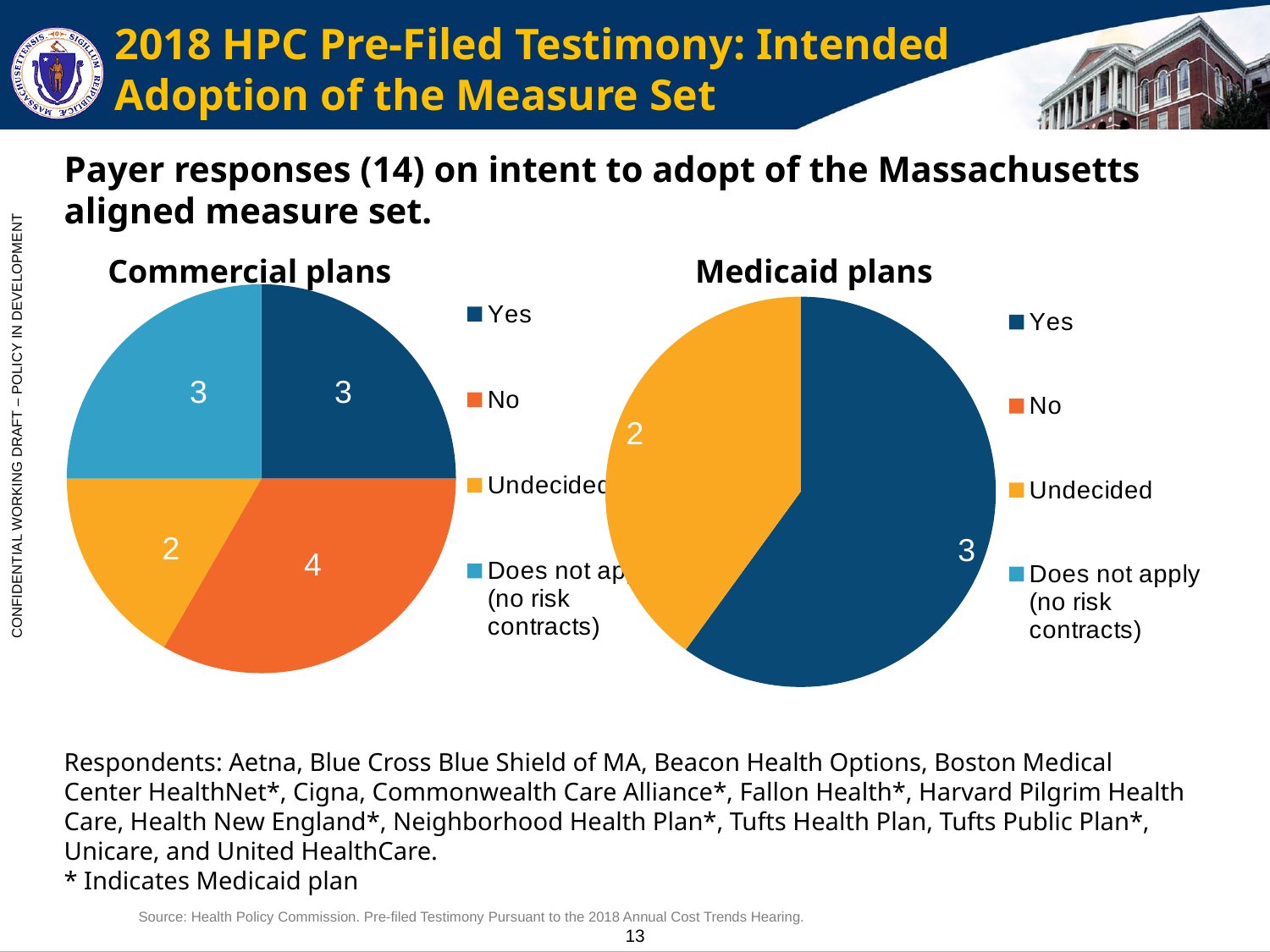
In the Medicaid plans chart, which is larger, Yes or Undecided? Yes In the Commercial plans chart, how many payers answered Does not apply (no risk contracts)? 3 In the Medicaid plans chart, how many payers answered Yes? 3 How many entries does the legend of the Medicaid plans chart list? 4 In the Commercial plans chart, how many payers answered Yes? 3 In the Commercial plans chart, which response has the largest slice? No In the Commercial plans chart, what is the difference between the No and Undecided counts? 2 In the Commercial plans chart, which response has the smallest slice? Undecided In the Medicaid plans chart, how many payers were Undecided? 2 In the Commercial plans chart, how many payers answered No? 4 In the Commercial plans chart, how many payers were Undecided? 2 What type of chart is used for the Commercial plans data? Pie chart